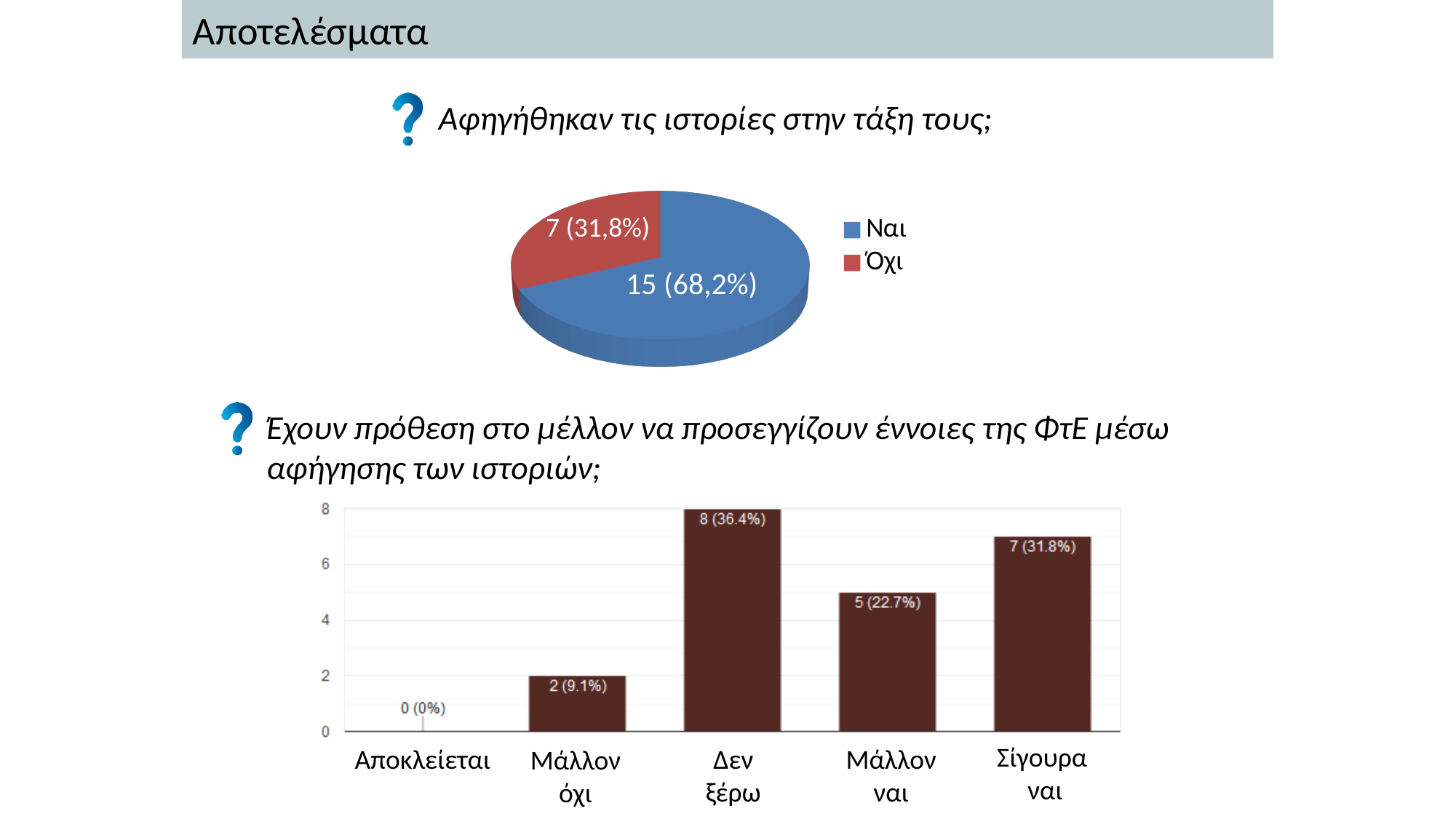
In the bar chart at the bottom of the slide, what value is shown for Δεν ξέρω? 8 (36.4%) In the bar chart at the bottom of the slide, what value is shown for Μάλλον ναι? 5 (22.7%) In the bar chart at the bottom of the slide, which category has the lowest value? Αποκλείεται In the bar chart at the bottom of the slide, what is the difference between the counts for Δεν ξέρω and Μάλλον όχι? 6 In the bar chart at the bottom of the slide, how many categories are shown on the x axis? 5 In the pie chart at the top of the slide, what value is shown for Ναι? 15 (68,2%) In the pie chart at the top of the slide, what share of the pie does the Όχι slice represent? 31,8% In the pie chart at the top of the slide, which colour is used for the Ναι slice? Blue In the pie chart at the top of the slide, what value is shown for Όχι? 7 (31,8%) In the bar chart at the bottom of the slide, which category has the highest value? Δεν ξέρω In the pie chart at the top of the slide, how many entries does the legend list? 2 What kind of chart is shown at the bottom of the slide? Bar chart